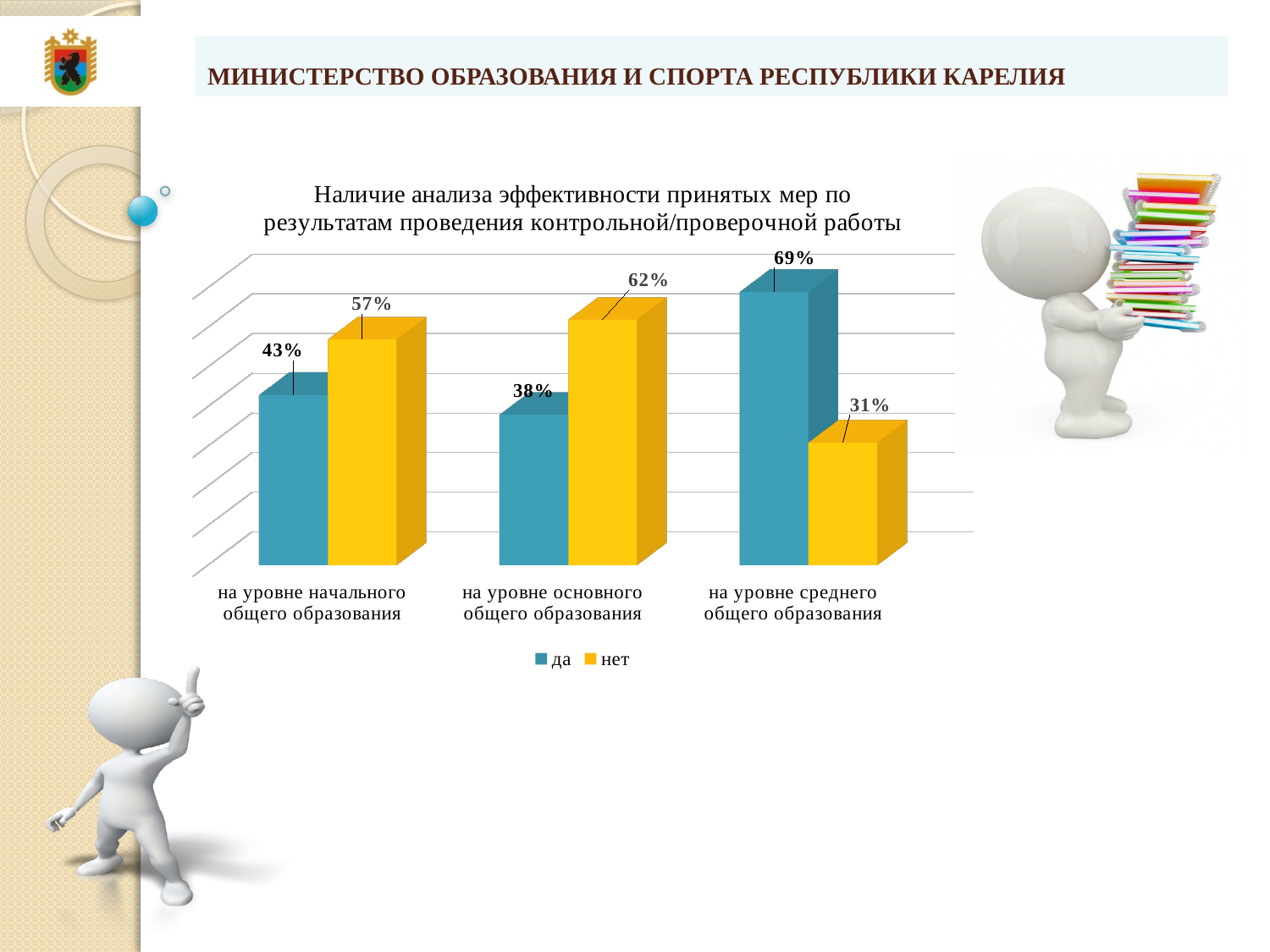
What kind of chart is shown on the slide? bar chart Which education level has the highest value for "да"? на уровне среднего общего образования How many education levels (categories) are shown on the chart? 3 Which series is shown in yellow according to the legend? нет What is the value for "да" at the level "на уровне начального общего образования"? 43% Which education level has the lowest value for "нет"? на уровне среднего общего образования What is the value for "нет" at the level "на уровне основного общего образования"? 62% What is the value for "да" at the level "на уровне среднего общего образования"? 69% How many series does the legend list? 2 What is the difference between the "нет" and "да" values at the level "на уровне основного общего образования"? 24% At the level "на уровне начального общего образования", which is larger: "да" or "нет"? нет What is the value for "нет" at the level "на уровне среднего общего образования"? 31%